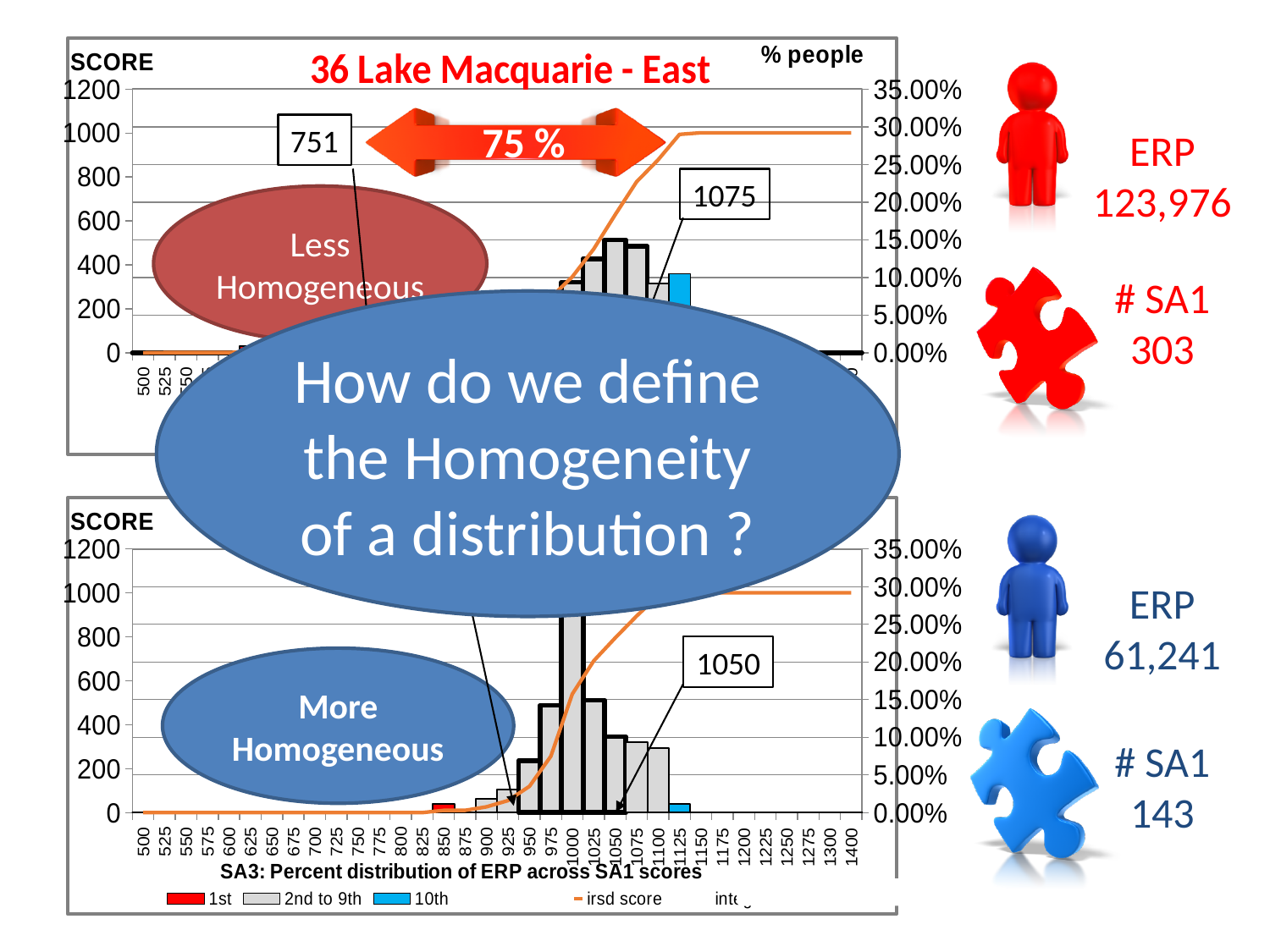
In the top chart, what value is shown in the callout box on the right side? 1075 What is the title of the top chart? 36 Lake Macquarie - East In the bottom chart, what value is shown in the callout box on the right side? 1050 In the bottom chart, which bar is taller: the one at score 975 or the one at score 1125? 975 In the bottom chart, is the bar at score 975 greater or less than 200 on the left axis? greater What kind of chart is the bottom chart? combination bar and line chart In the top chart, what percentage is printed on the red double-headed arrow? 75 % In the bottom chart, which x-axis score has the tallest bar? 1000 In the bottom chart, does the orange irsd score line rise or fall as the score increases along the x axis? rises In the bottom chart's legend, which colour represents the '10th' series? blue In the bottom chart, is the bar at score 1050 greater or less than 600 on the left axis? less In the top chart, what value is shown in the callout box on the left side? 751